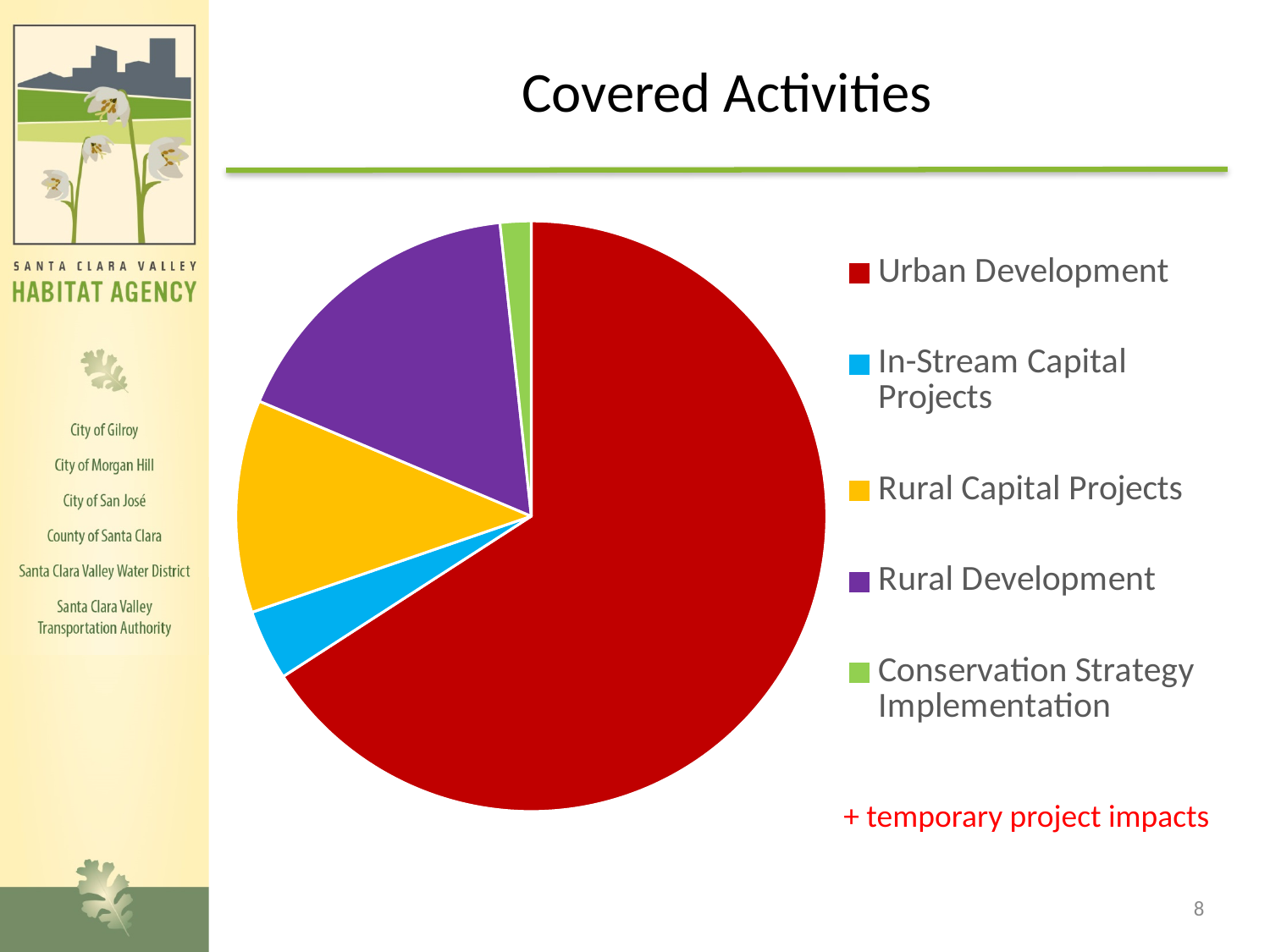
How many categories does the pie chart show? 5 What kind of chart is shown on the slide? pie chart Which slice is larger: Urban Development or Rural Development? Urban Development Which slice is smaller: In-Stream Capital Projects or Conservation Strategy Implementation? Conservation Strategy Implementation Which slice is larger: Rural Capital Projects or In-Stream Capital Projects? Rural Capital Projects How many entries does the legend list? 5 What colour is the Urban Development slice? red Which category has the largest slice of the pie? Urban Development Which category has the smallest slice of the pie? Conservation Strategy Implementation What is the title of the chart? Covered Activities